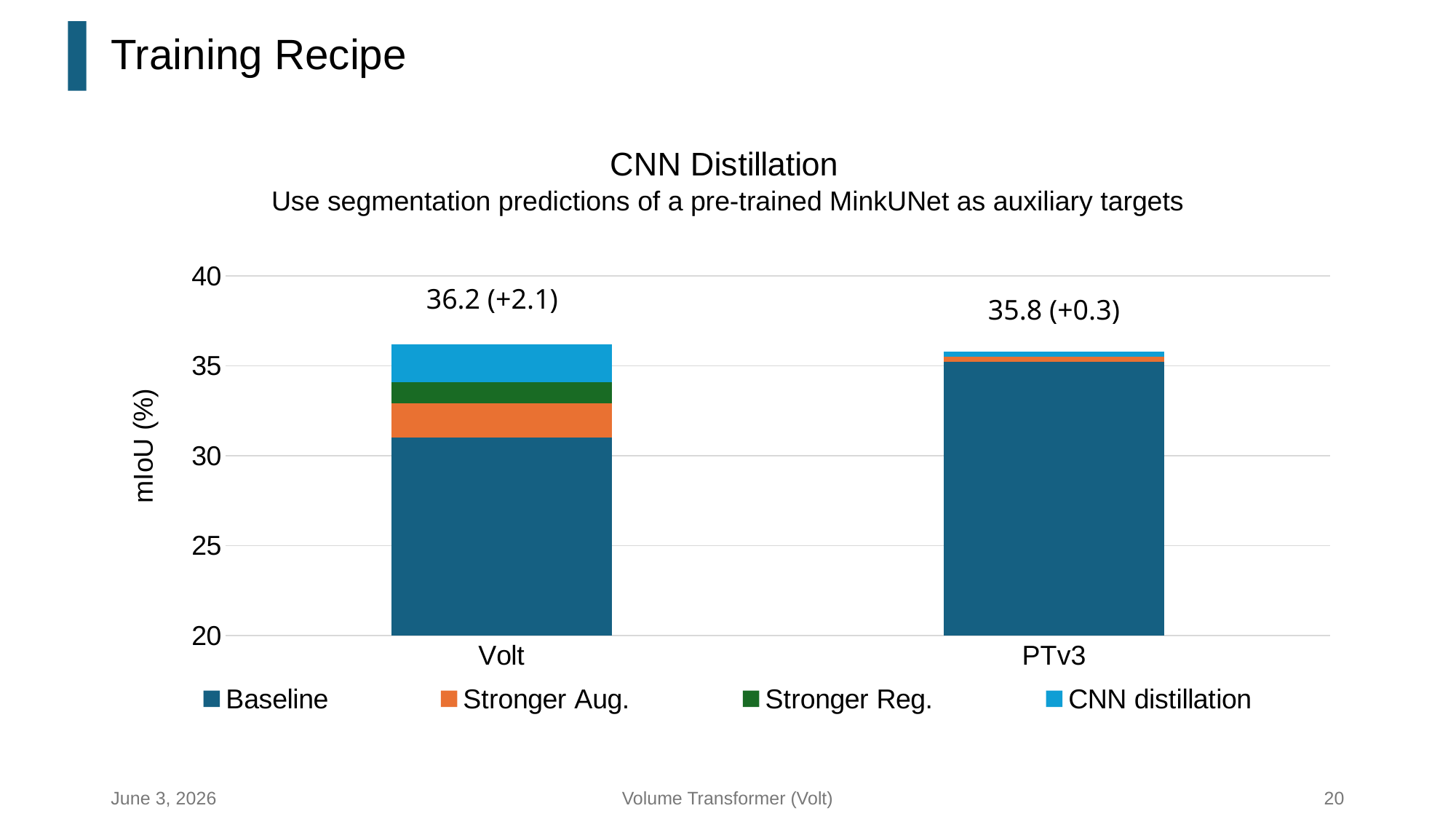
What is the difference between the total mIoU of Volt and PTv3? 0.4 What is the total mIoU value labelled above the PTv3 bar? 35.8 How many models (categories) are shown on the x axis? 2 Which model has the higher total mIoU, Volt or PTv3? Volt Is the Baseline value for Volt greater or less than 35? less What is the total mIoU value labelled above the Volt bar? 36.2 What kind of chart is shown on the slide? Stacked bar chart How many series does the legend list? 4 What gain is shown in parentheses next to the Volt bar's label? +2.1 Is the Baseline value for Volt greater or less than 30? greater What gain is shown in parentheses next to the PTv3 bar's label? +0.3 What is the label of the y axis? mIoU (%)